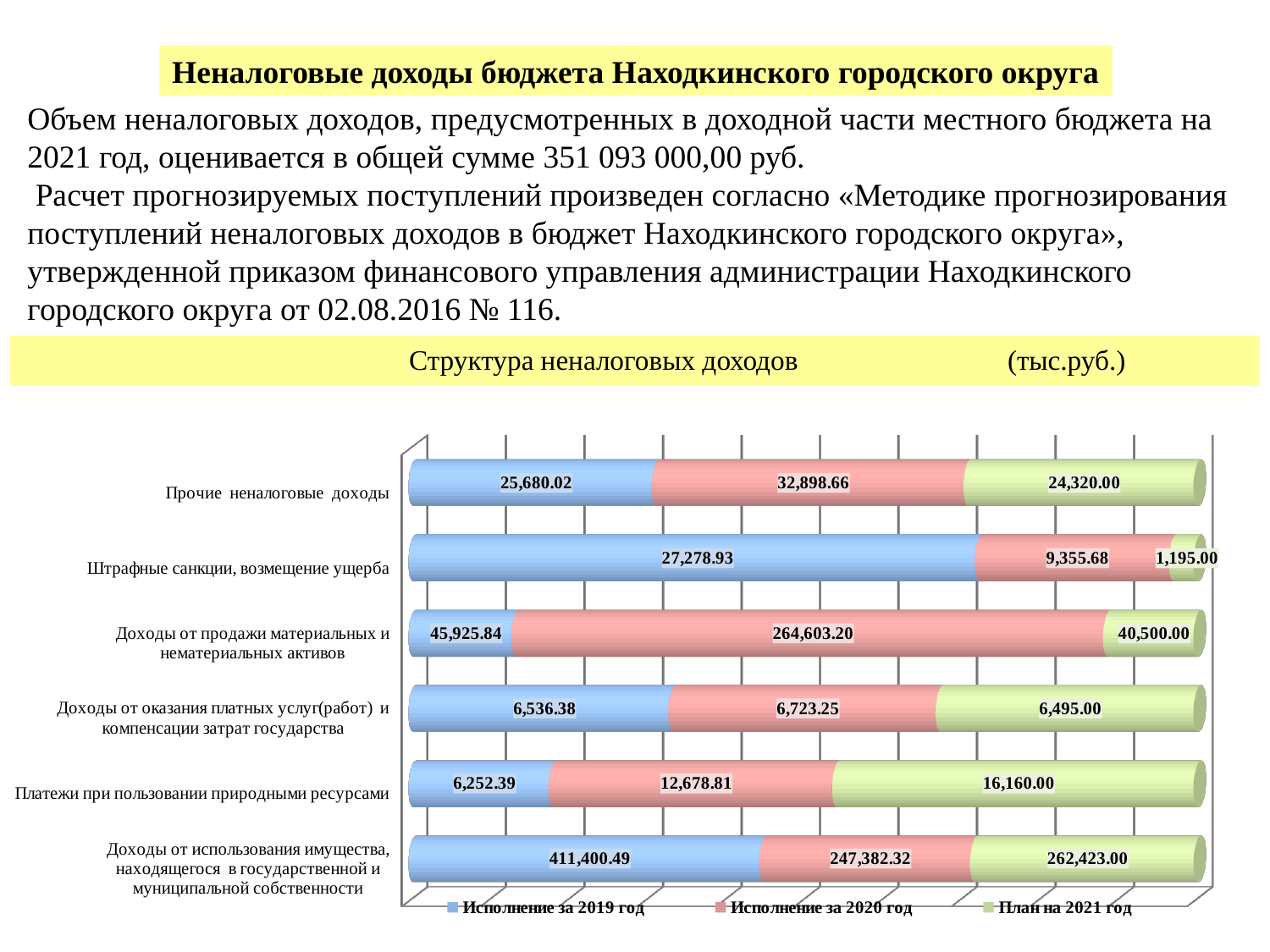
For 'Платежи при пользовании природными ресурсами', what is the difference between 'План на 2021 год' and 'Исполнение за 2019 год'? 9,907.61 What are the three legend entries of the chart? Исполнение за 2019 год, Исполнение за 2020 год, План на 2021 год What is the value of 'Исполнение за 2019 год' for 'Доходы от использования имущества, находящегося в государственной и муниципальной собственности'? 411,400.49 What is the value of 'План на 2021 год' for 'Штрафные санкции, возмещение ущерба'? 1,195.00 How many categories are plotted in the chart? 6 How many series does the chart legend list? 3 Which category has the lowest value for 'План на 2021 год'? Штрафные санкции, возмещение ущерба What is the total of the three series for 'Платежи при пользовании природными ресурсами'? 35,091.20 What is the value of 'Исполнение за 2020 год' for 'Доходы от продажи материальных и нематериальных активов'? 264,603.20 Which category has the highest value for 'План на 2021 год'? Доходы от использования имущества, находящегося в государственной и муниципальной собственности What kind of chart is shown on the slide? Stacked bar chart For 'Штрафные санкции, возмещение ущерба', which is larger: 'Исполнение за 2019 год' or 'Исполнение за 2020 год'? Исполнение за 2019 год